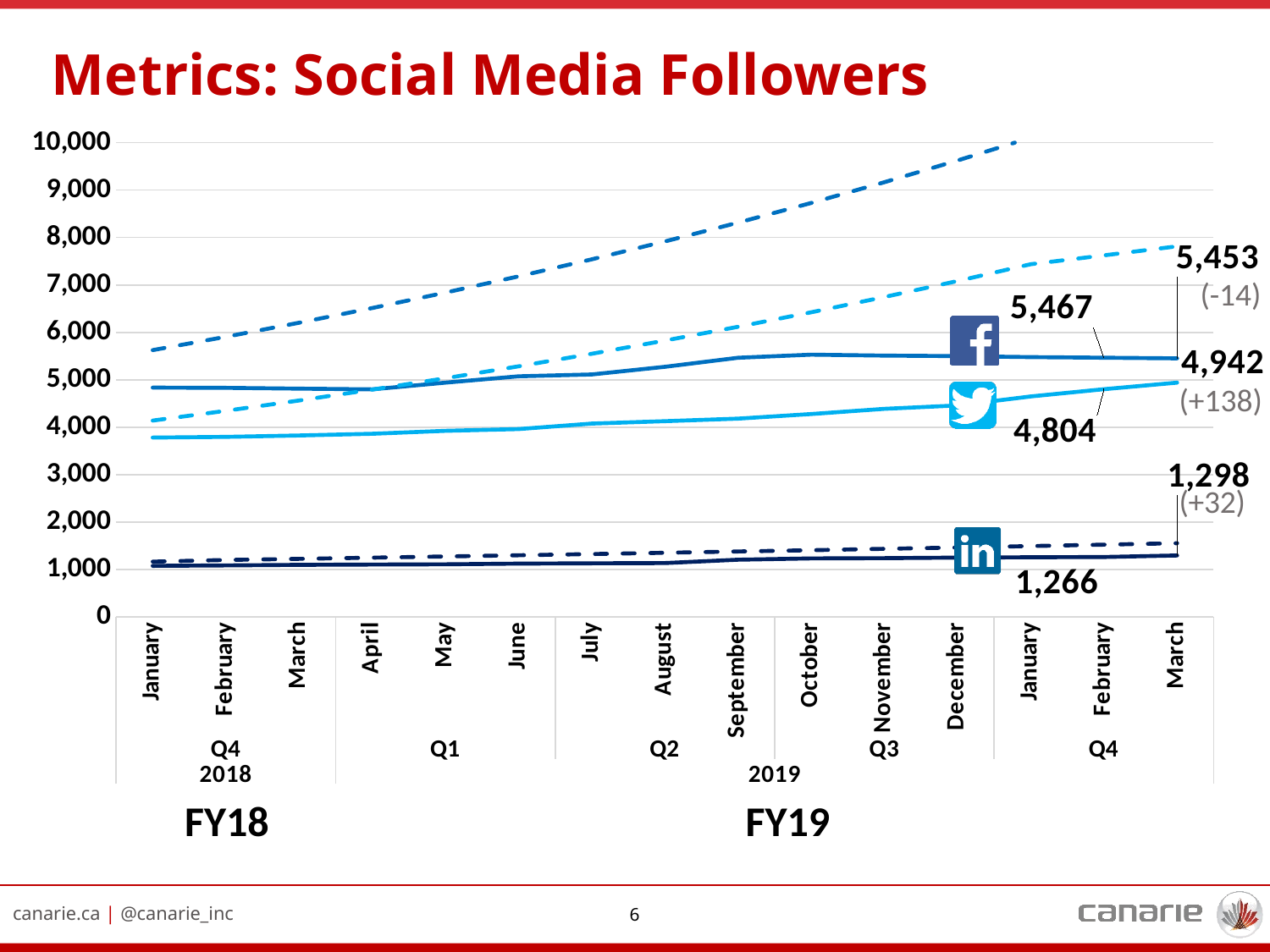
What is the title of the chart on the slide? Metrics: Social Media Followers Is the final LinkedIn follower value greater or less than 2,000? less What is the Facebook follower count labelled at the end of the chart (March, FY19 Q4)? 5,453 What type of chart is shown on the slide? line chart What is the LinkedIn follower count labelled at the end of the chart (March, FY19 Q4)? 1,298 How many months are shown along the x axis? 15 Which social media platform has the lowest follower count at the end of the chart? LinkedIn What change in followers is shown in parentheses next to the Twitter value of 4,942? +138 Which social media platform has the highest follower count at the end of the chart? Facebook What is the Twitter follower count labelled at the end of the chart (March, FY19 Q4)? 4,942 What is the difference between the final Facebook value (5,453) and the final Twitter value (4,942)? 511 What change in followers is shown in parentheses next to the Facebook value of 5,453? -14